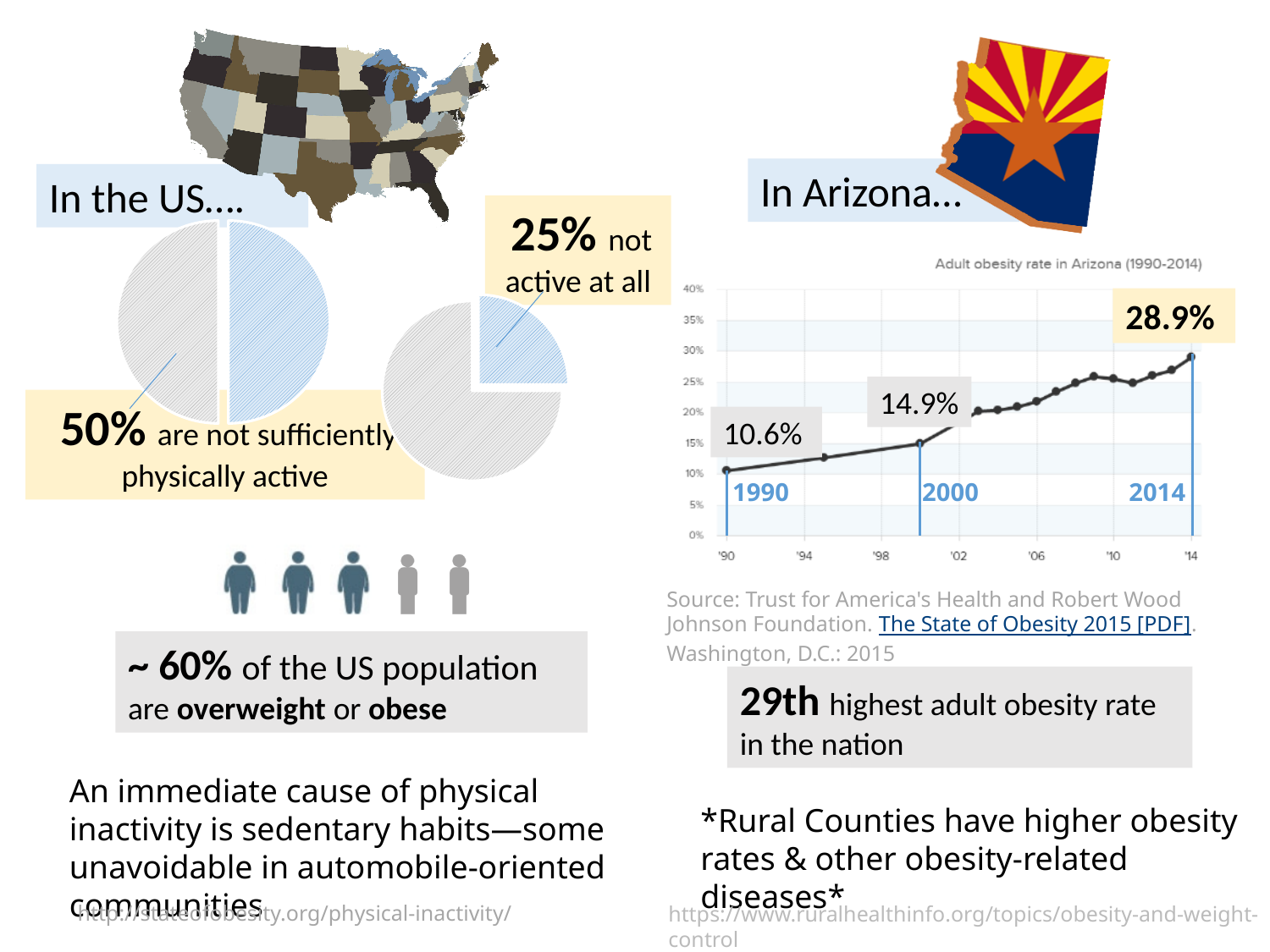
On the 'Adult obesity rate in Arizona (1990-2014)' chart, what was the adult obesity rate in 2000? 14.9% On the smaller pie chart under 'In the US....', what share of the population is not active at all? 25% On the 'Adult obesity rate in Arizona (1990-2014)' chart, which year has the highest adult obesity rate? 2014 On the 'Adult obesity rate in Arizona (1990-2014)' chart, does the adult obesity rate rise or fall over time? rise On the 'Adult obesity rate in Arizona (1990-2014)' chart, by how many percentage points did the rate increase from 1990 to 2014? 18.3 percentage points On the 'Adult obesity rate in Arizona (1990-2014)' chart, what was the adult obesity rate in 1990? 10.6% On the left pie chart under 'In the US....', what share of the population is not sufficiently physically active? 50% On the 'Adult obesity rate in Arizona (1990-2014)' chart, is the value for 1994 greater or less than 15%? less On the 'Adult obesity rate in Arizona (1990-2014)' chart, by how many percentage points did the rate increase from 2000 to 2014? 14 percentage points On the 'Adult obesity rate in Arizona (1990-2014)' chart, what was the adult obesity rate in 2014? 28.9% On the 'Adult obesity rate in Arizona (1990-2014)' chart, is the value for 2010 greater or less than 20%? greater What kind of chart is the 'Adult obesity rate in Arizona (1990-2014)' chart? line chart